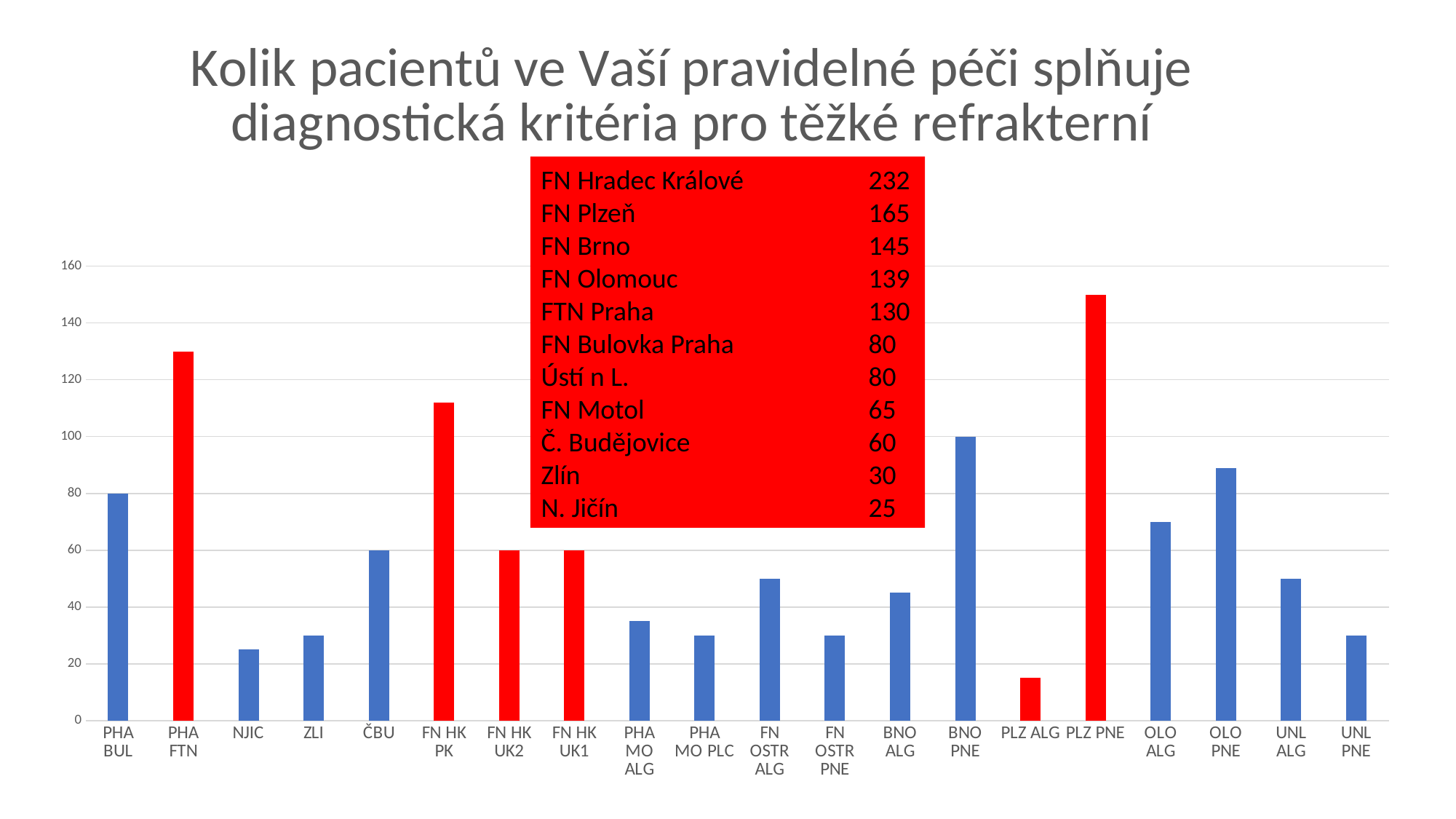
What is the value for ČBU? 60 What is the value for BNO PNE? 100 What kind of chart is shown on the slide? bar chart What is the difference between the values for BNO PNE and PHA BUL? 20 How many categories are shown on the x axis of the chart? 20 Is the value for PLZ ALG greater or less than 20? less Which category has the highest bar in the chart? PLZ PNE Which is larger, the value for OLO PNE or the value for OLO ALG? OLO PNE Which category has the lowest bar in the chart? PLZ ALG What is the value for PHA BUL? 80 Is the value for PHA FTN greater or less than 120? greater What colour are the bars for PHA FTN, FN HK PK and PLZ PNE? red